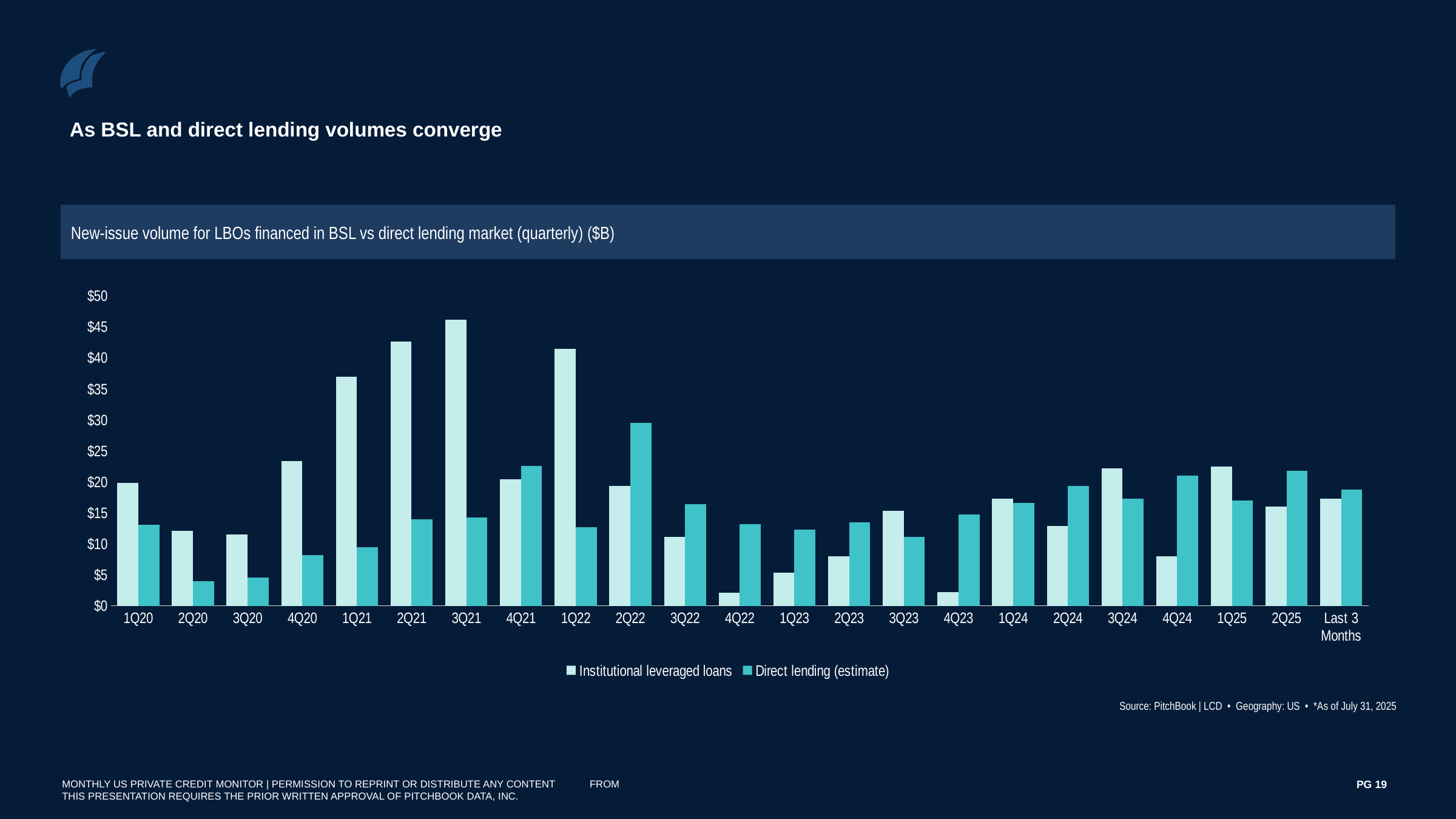
How many series does the legend list? 2 In which quarter is the Direct lending (estimate) value highest? 2Q22 In 4Q24, which is larger: Institutional leveraged loans or Direct lending (estimate)? Direct lending (estimate) Do the Institutional leveraged loans values rise or fall from 4Q22 to 3Q23? rise Is the Institutional leveraged loans value for 3Q21 greater or less than $40? greater What is the title of the chart? New-issue volume for LBOs financed in BSL vs direct lending market (quarterly) ($B) How many categories are shown along the x axis? 23 Is the Institutional leveraged loans value for 4Q22 greater or less than $5? less In which quarter is the Institutional leveraged loans value highest? 3Q21 What kind of chart is shown on the slide? Bar chart In 1Q22, which is larger: Institutional leveraged loans or Direct lending (estimate)? Institutional leveraged loans Is the Direct lending (estimate) value for 2Q22 greater or less than $25? greater